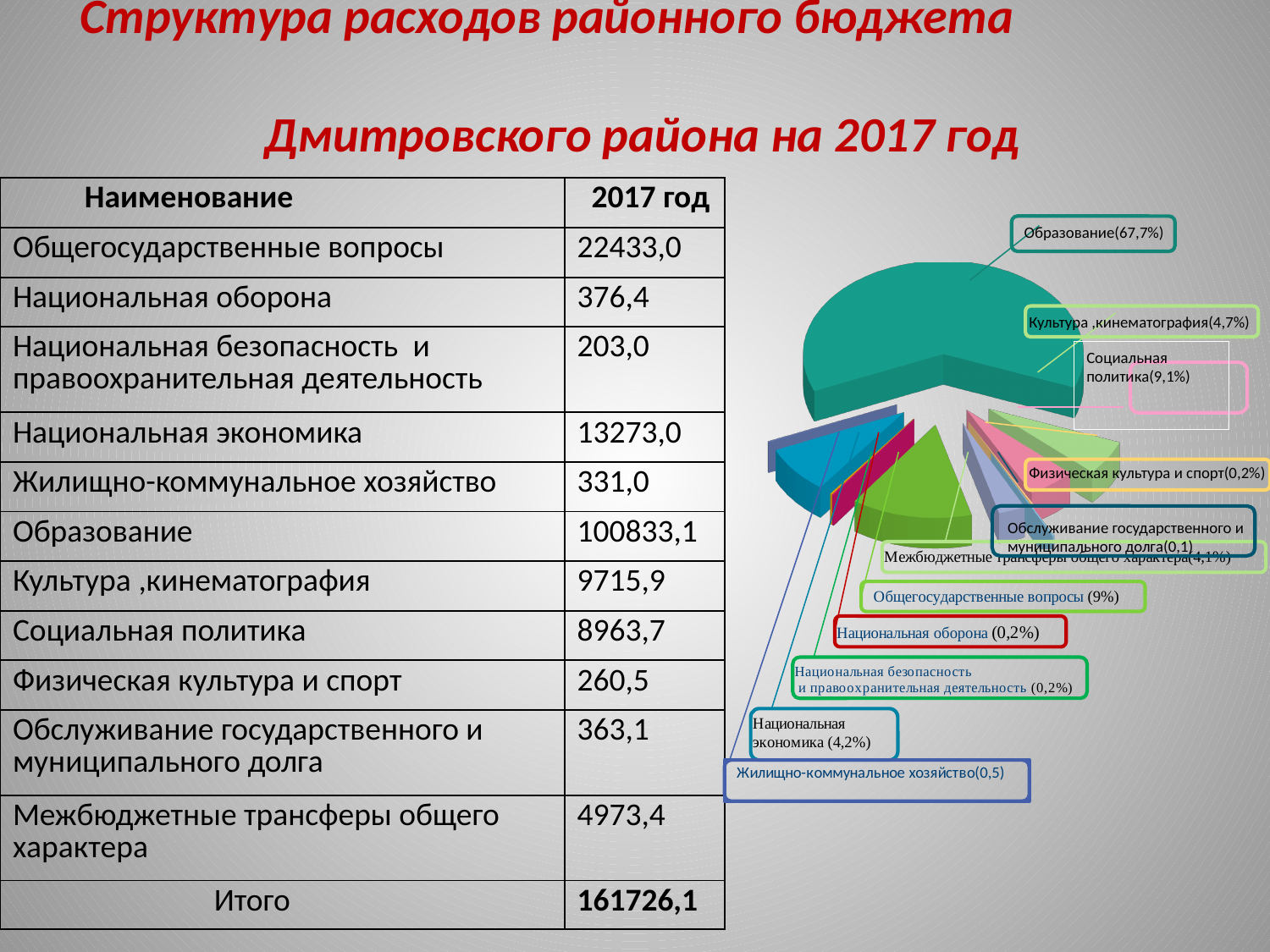
What share of the pie chart does Физическая культура и спорт have? 0,2% What share of the pie chart does Культура, кинематография have? 4,7% What share of the pie chart does Жилищно-коммунальное хозяйство have? 0,5 Which has the larger share of the pie chart, Образование or Социальная политика? Образование Which category has the largest share of the pie chart? Образование How many slices does the pie chart have? 11 What kind of chart is shown on the slide? pie chart Which has the larger share of the pie chart, Культура, кинематография or Национальная оборона? Культура, кинематография